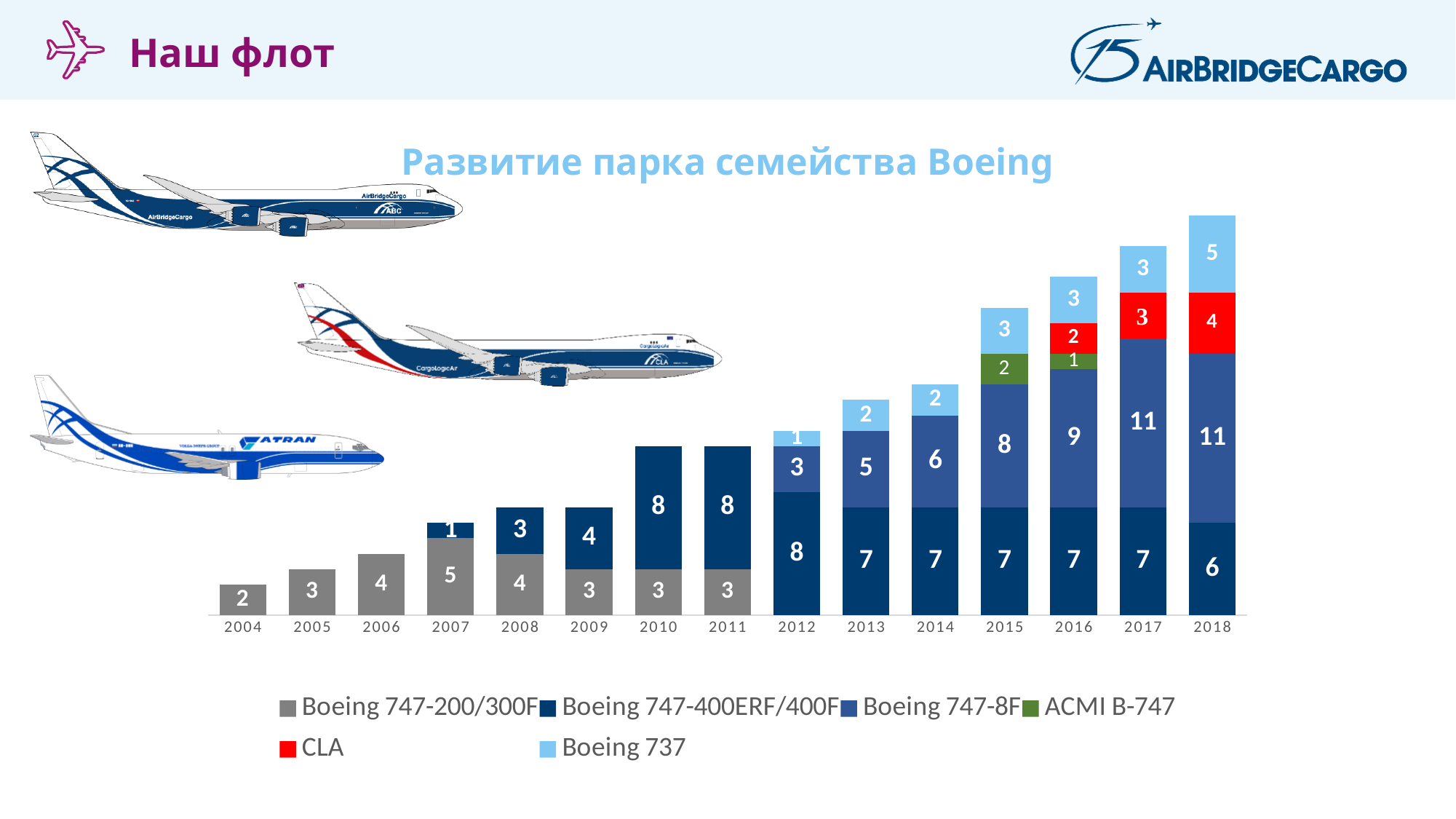
How many years are shown on the x axis? 15 What is the value for Boeing 747-200/300F in 2007? 5 How many series does the legend list? 6 Which year has the lowest total fleet size? 2004 What is the value for Boeing 737 in 2018? 5 What is the value for CLA in 2016? 2 What is the total of the stacked bar for 2015? 20 What is the value for Boeing 747-8F in 2017? 11 Which is larger, the Boeing 747-8F value in 2015 or the Boeing 747-400ERF/400F value in 2015? Boeing 747-8F What is the total of the stacked bar for 2018? 26 What kind of chart is shown on the slide? stacked bar chart What is the difference between the Boeing 747-400ERF/400F values in 2012 and 2018? 2